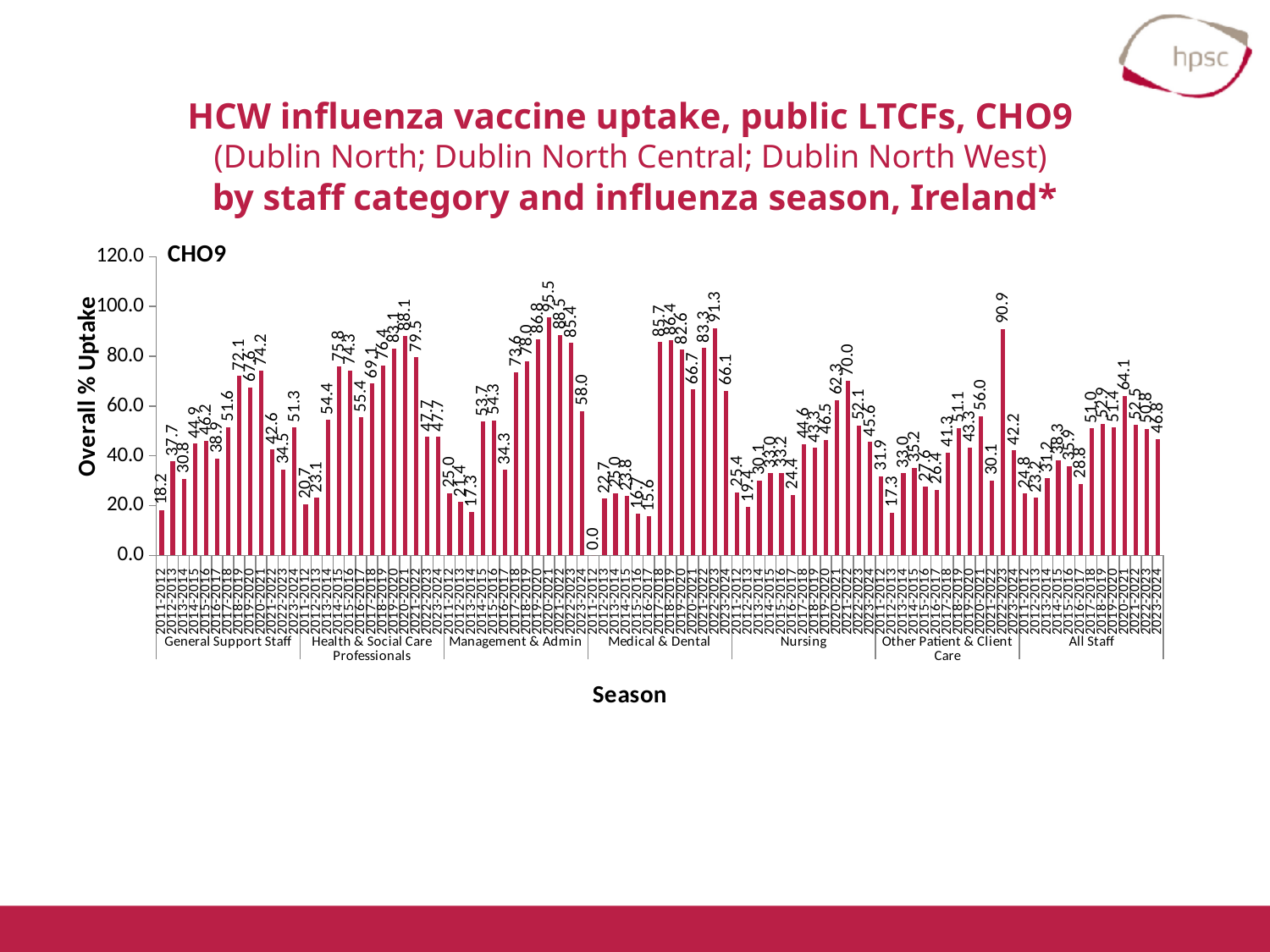
What is the overall % uptake for General Support Staff in the 2011-2012 season? 18.2 What kind of chart is shown on the slide? Bar chart Which staff category and season has the highest overall % uptake on the chart? Management & Admin, 2020-2021 Is the overall % uptake for Other Patient & Client Care in 2022-2023 greater or less than 80? greater For All Staff, what is the difference in overall % uptake between the 2020-2021 season (64.1) and the 2016-2017 season (28.8)? 35.3 Which staff category and season has the lowest overall % uptake on the chart? Medical & Dental, 2011-2012 How many staff categories are shown along the x axis of the chart? 7 For Management & Admin, which season has the higher overall % uptake: 2016-2017 or 2023-2024? 2023-2024 What is the overall % uptake for Other Patient & Client Care staff in the 2022-2023 season? 90.9 What is the overall % uptake for All Staff in the 2020-2021 season? 64.1 What is the title of the y axis of the chart? Overall % Uptake What is the overall % uptake for Medical & Dental staff in the 2011-2012 season? 0.0